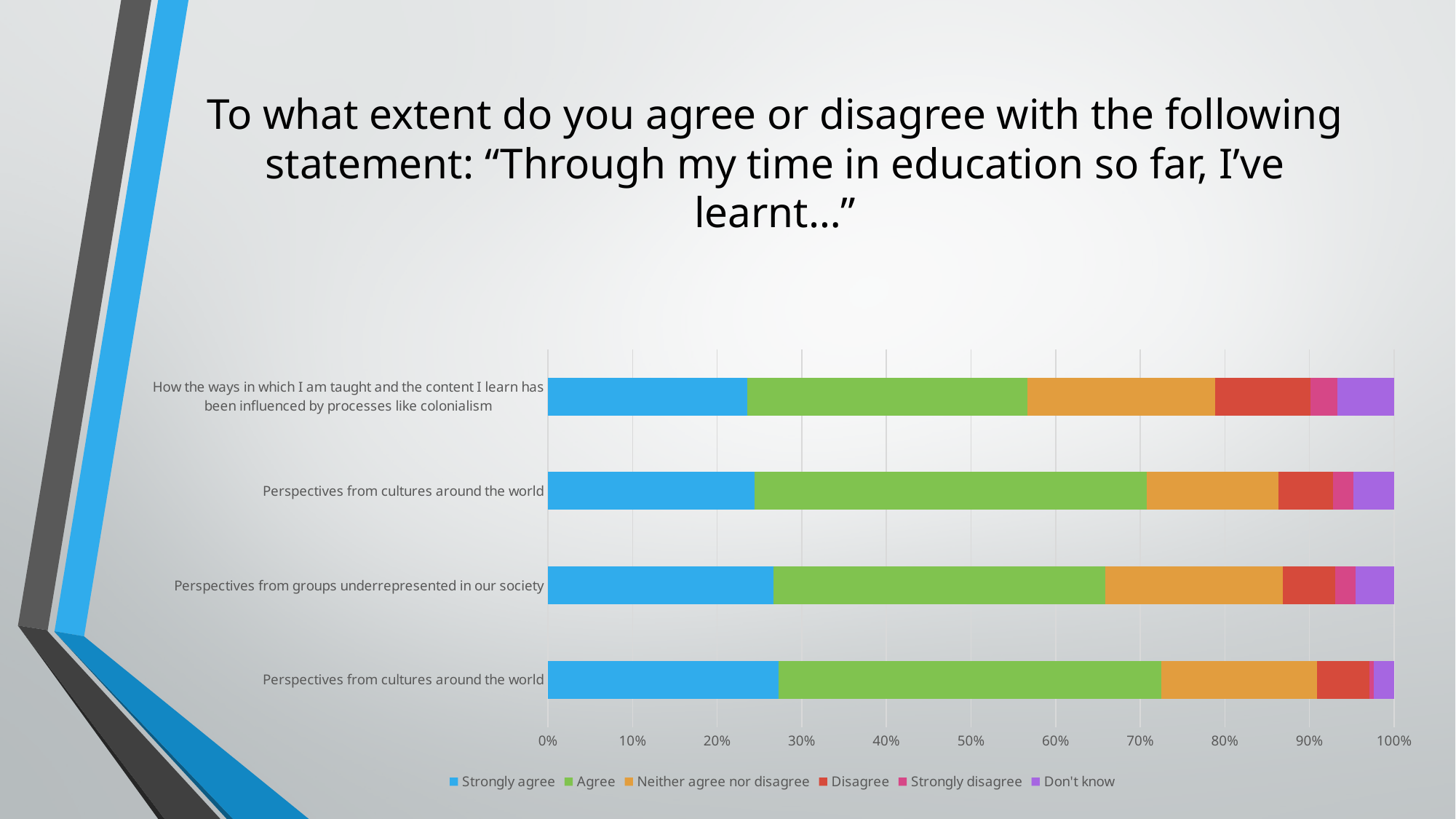
Which legend entry is listed first? Strongly agree Is the 'Strongly agree' share for 'How the ways in which I am taught and the content I learn has been influenced by processes like colonialism' greater or less than 20%? greater Which statement has the largest 'Disagree' share? How the ways in which I am taught and the content I learn has been influenced by processes like colonialism What colour represents 'Agree' in the chart? Green Is the 'Strongly agree' share for 'Perspectives from groups underrepresented in our society' greater or less than 20%? greater How many series does the legend list? 6 How many statements (bars) are plotted in the chart? 4 Is the 'Strongly agree' share for 'Perspectives from groups underrepresented in our society' greater or less than 30%? less What kind of chart is shown on the slide? Stacked bar chart Is the 'Disagree' share larger for the colonialism statement or for 'Perspectives from groups underrepresented in our society'? The colonialism statement Which statement has the largest 'Don't know' share? How the ways in which I am taught and the content I learn has been influenced by processes like colonialism